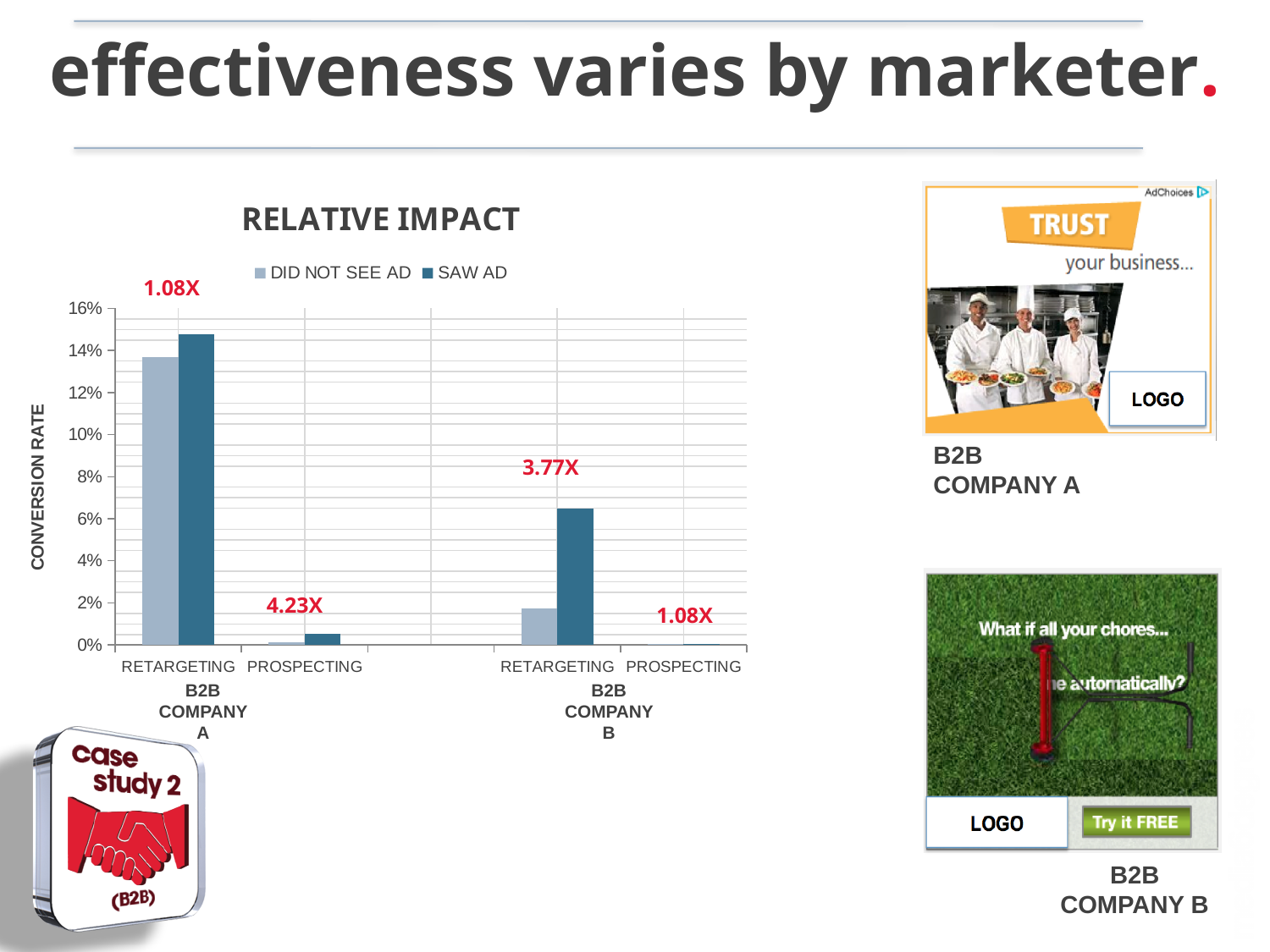
For RETARGETING at B2B COMPANY B, which is larger: the SAW AD bar or the DID NOT SEE AD bar? SAW AD What multiplier is printed above the RETARGETING bars for B2B COMPANY A? 1.08X Is the SAW AD conversion rate for RETARGETING at B2B COMPANY A greater or less than 14%? greater How many category groups (pairs of bars) are plotted on the x axis of the RELATIVE IMPACT chart? 4 What kind of chart is shown under the title RELATIVE IMPACT? bar chart How many series does the legend of the RELATIVE IMPACT chart list? 2 What multiplier is printed above the RETARGETING bars for B2B COMPANY B? 3.77X Is the SAW AD conversion rate for RETARGETING at B2B COMPANY B greater or less than 6%? greater What multiplier is printed above the PROSPECTING bars for B2B COMPANY A? 4.23X Which bar in the RELATIVE IMPACT chart is the highest? SAW AD for RETARGETING, B2B COMPANY A What is the label on the vertical axis of the RELATIVE IMPACT chart? CONVERSION RATE What are the two series named in the legend of the RELATIVE IMPACT chart? DID NOT SEE AD and SAW AD